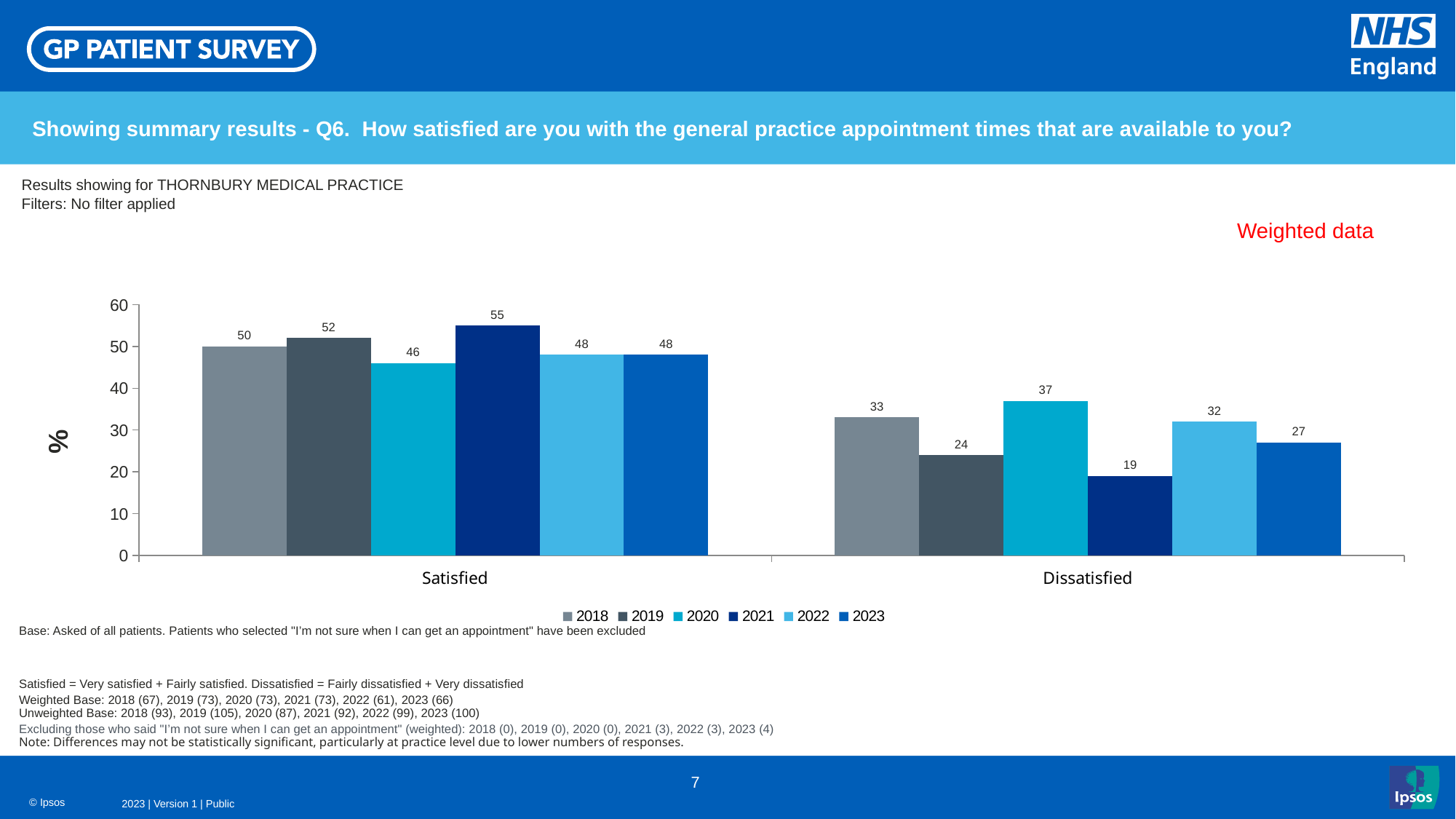
Which year has the highest value in the Satisfied category? 2021 What is the value for 2020 in the Dissatisfied category? 37 Which is larger in the Dissatisfied category: the value for 2018 or the value for 2019? 2018 How many series does the legend list? 6 What is the label on the vertical axis of the chart? % What is the difference between the 2020 and 2019 values in the Dissatisfied category? 13 Which year has the lowest value in the Dissatisfied category? 2021 How many categories are shown on the x axis? 2 What is the difference between the 2021 and 2020 values in the Satisfied category? 9 What kind of chart is shown on the slide? Bar chart What is the value for 2021 in the Satisfied category? 55 What is the value for 2023 in the Dissatisfied category? 27